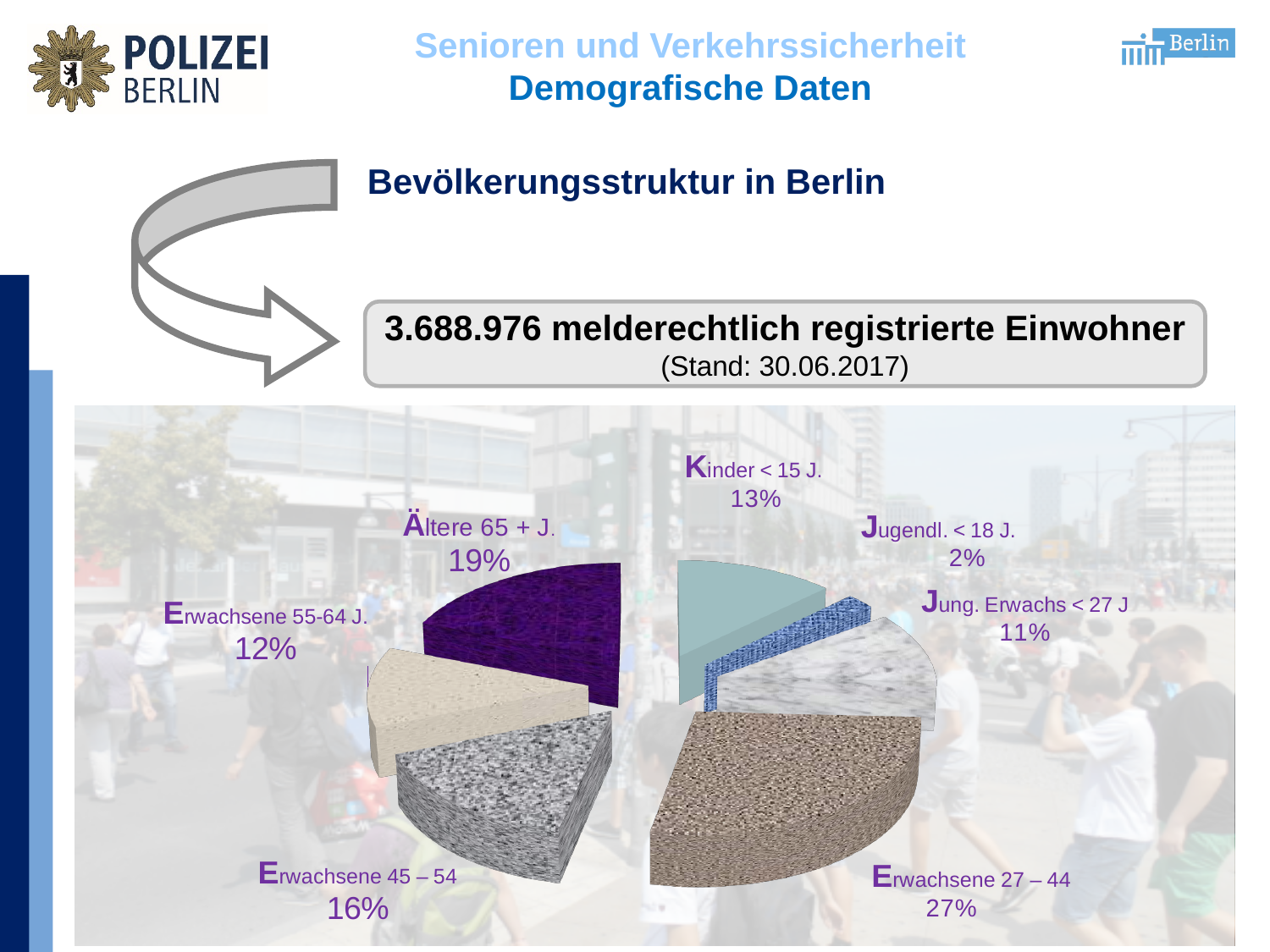
What share of the population is shown for Erwachsene 55-64 J.? 12% What share of the population is shown for Ältere 65 + J.? 19% What total number of registered inhabitants is stated above the chart? 3.688.976 What is the difference in percentage points between Erwachsene 27 – 44 and Erwachsene 45 – 54? 11 Which age group has the smallest share of the pie? Jugendl. < 18 J. What share of the population is shown for Erwachsene 27 – 44? 27% What share of the population is shown for Jugendl. < 18 J.? 2% Which is larger, the share for Ältere 65 + J. or the share for Erwachsene 45 – 54? Ältere 65 + J. What share of the population is shown for Kinder < 15 J.? 13% What kind of chart is shown on the slide? pie chart How many age groups (slices) does the pie chart show? 7 Which age group has the largest share of the pie? Erwachsene 27 – 44